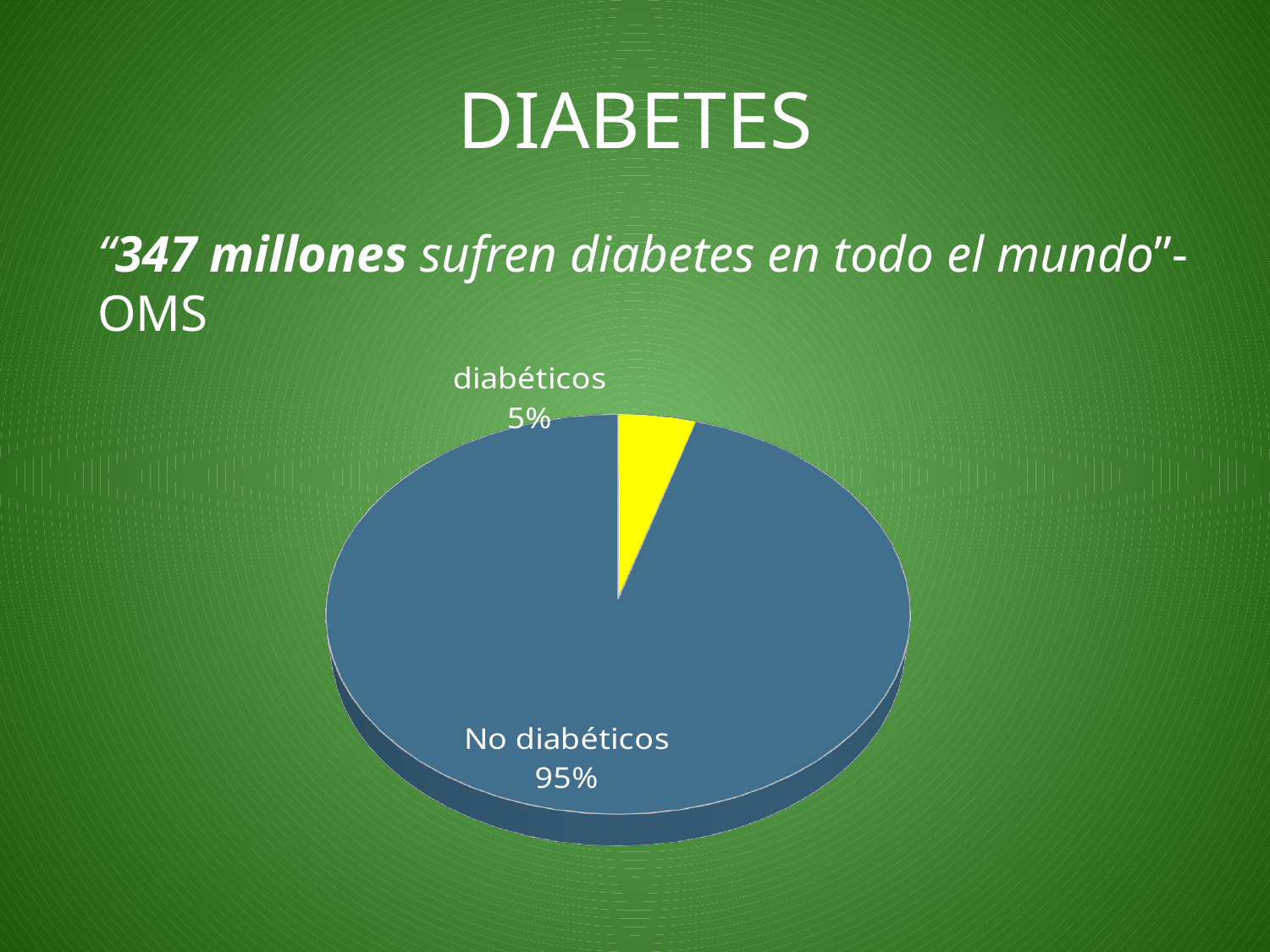
What colour is the "diabéticos" slice of the pie chart? Yellow Which slice of the pie chart is the largest? No diabéticos How many slices does the pie chart have? 2 What is the difference in percentage points between the "No diabéticos" and "diabéticos" slices? 90 What percentage of the pie chart is labelled "diabéticos"? 5% What kind of chart is shown on the slide? Pie chart What colour is the "No diabéticos" slice of the pie chart? Blue What share of the pie does the "diabéticos" slice represent? 5% What percentage of the pie chart is labelled "No diabéticos"? 95% Which slice of the pie chart is the smallest? diabéticos Which slice is larger, "diabéticos" or "No diabéticos"? No diabéticos